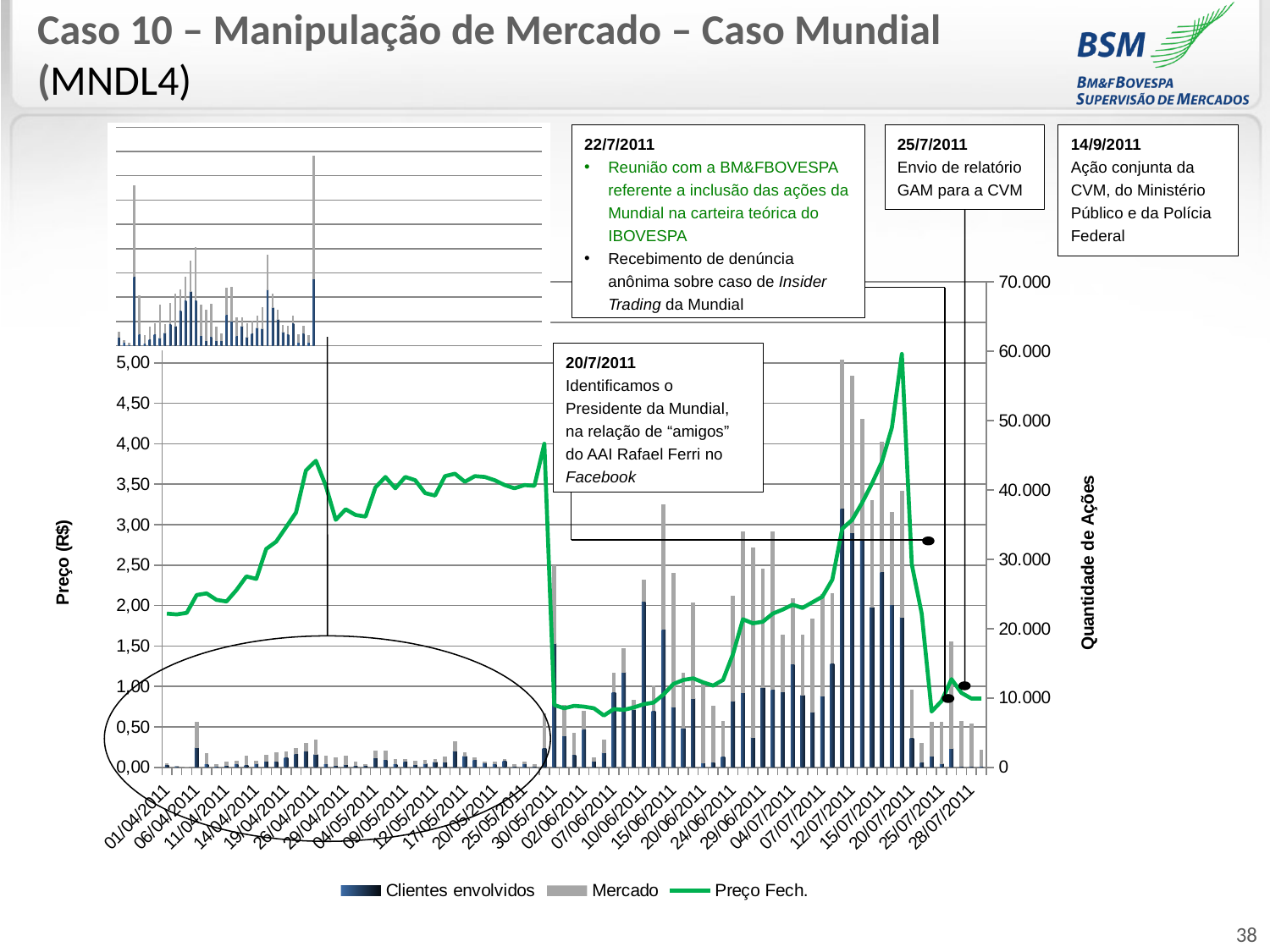
Is the Preço Fech. value around 29/04/2011 greater or less than 3,50? less Does the Preço Fech. line rise or fall between 20/07/2011 and 28/07/2011? fall How many series does the chart legend list? 3 Does the Preço Fech. line rise or fall between 01/04/2011 and 29/04/2011? rise What kind of chart is shown on the slide? Combination bar and line chart Is the Preço Fech. value around 25/07/2011 greater or less than 2,00? less What are the three series named in the chart legend? Clientes envolvidos, Mercado, Preço Fech. Is the Preço Fech. value around 30/05/2011 greater or less than 1,00? less Around 12/07/2011, which series has the larger value, Mercado or Clientes envolvidos? Clientes envolvidos What is the title of the left vertical axis of the chart? Preço (R$)